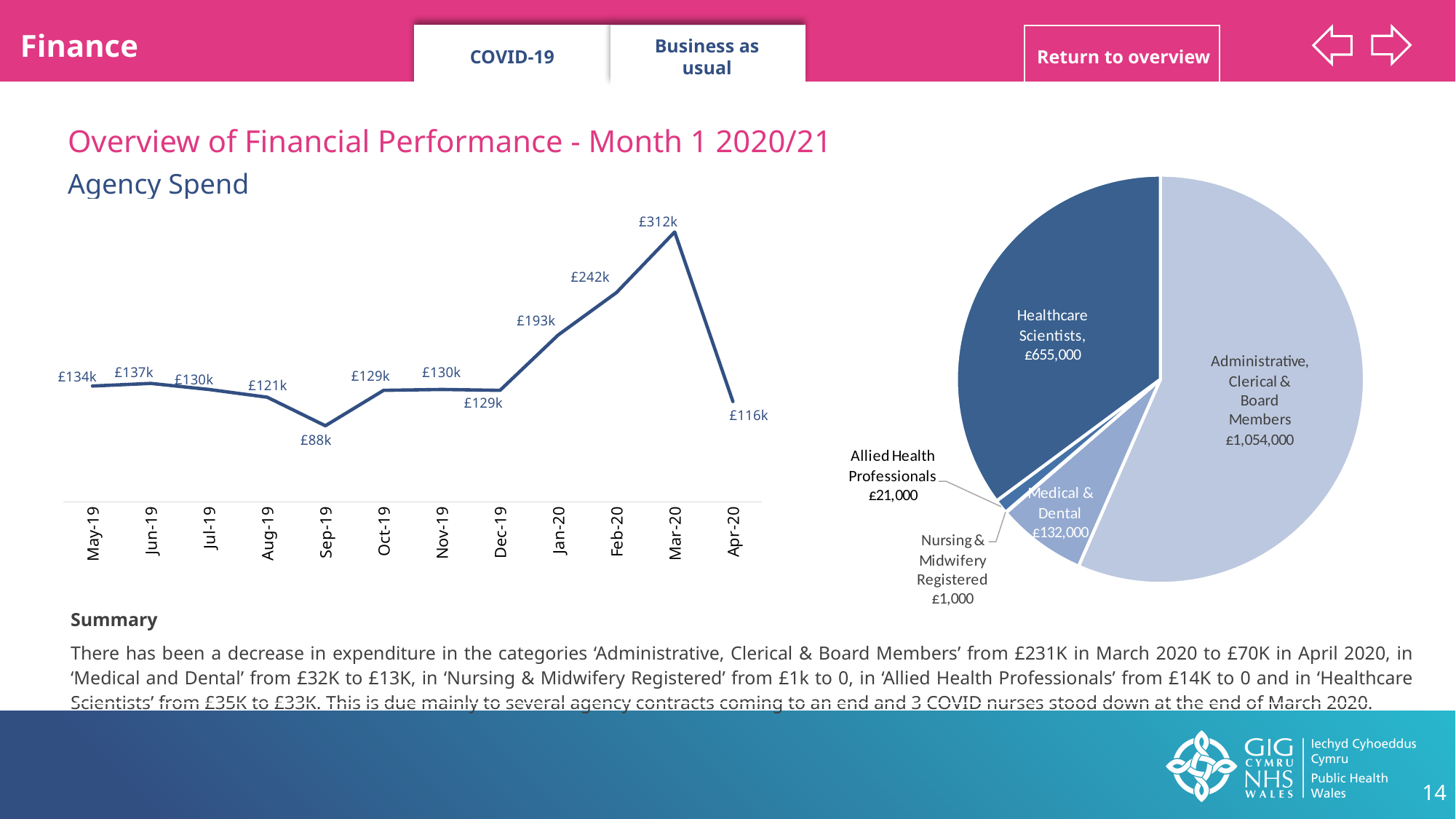
In the pie chart on the right, which is larger: Medical & Dental or Allied Health Professionals? Medical & Dental In the pie chart on the right, which category has the smallest slice? Nursing & Midwifery Registered In the Agency Spend line chart, what was the value for Mar-20? £312k In the Agency Spend line chart, which month has the lowest value? Sep-19 In the Agency Spend line chart, how many months are plotted? 12 What kind of chart is the Agency Spend chart on the left of the slide? line chart In the Agency Spend line chart, what was the value for Sep-19? £88k In the pie chart on the right, what is the value for Healthcare Scientists? £655,000 In the Agency Spend line chart, what is the difference between the Mar-20 and Apr-20 values? £196k In the Agency Spend line chart, which month has the highest value? Mar-20 In the Agency Spend line chart, do the values rise or fall from Dec-19 to Mar-20? rise In the pie chart on the right, which category has the largest slice? Administrative, Clerical & Board Members